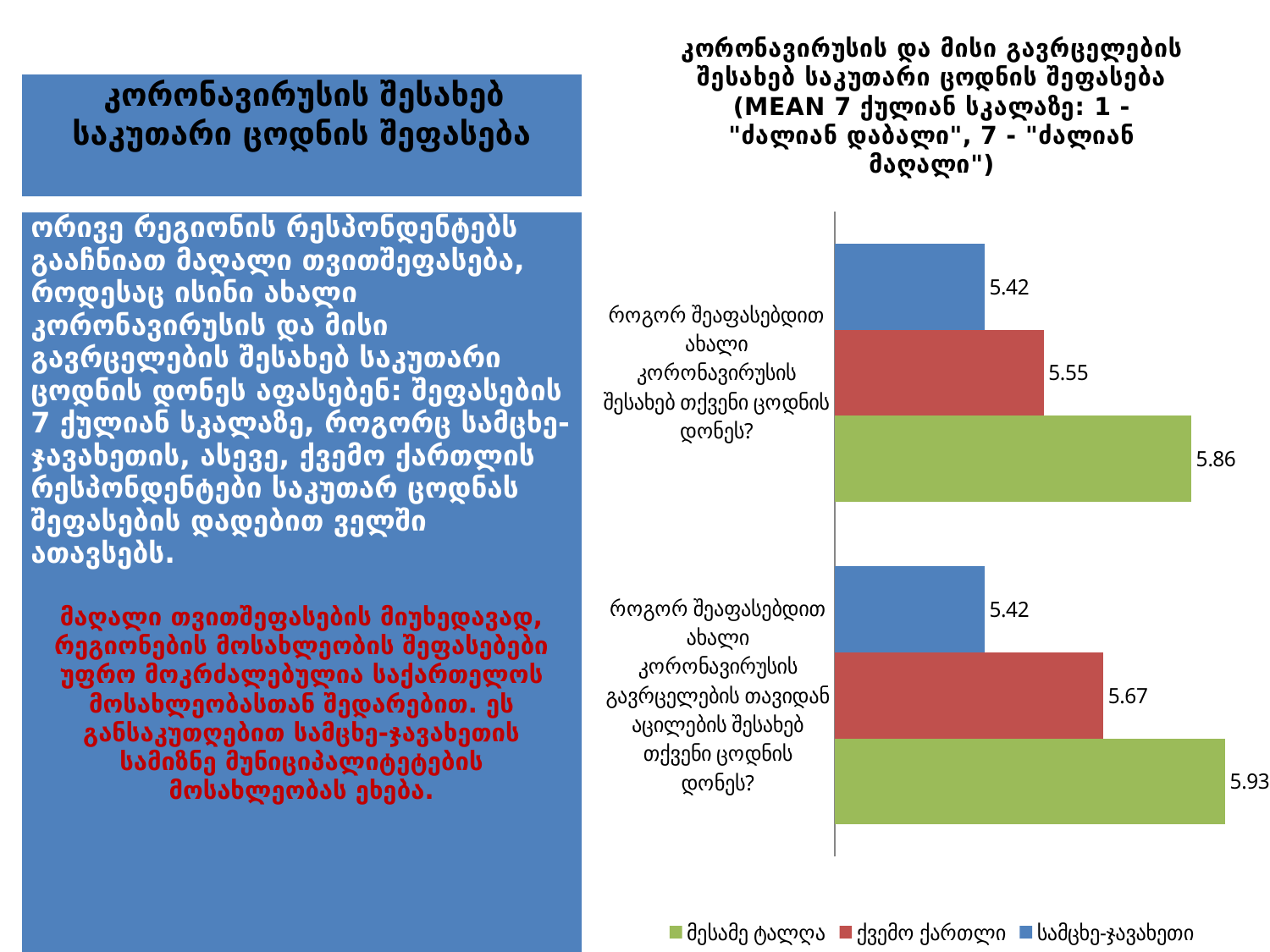
Which series has the highest value for the question about knowledge of preventing the spread of the coronavirus? მესამე ტალღა Which colour represents ქვემო ქართლი in the chart? red How many categories (questions) are plotted on the chart? 2 What is the difference between the ქვემო ქართლი and სამცხე-ჯავახეთი values for the question about knowledge of the new coronavirus? 0.13 What is the value for ქვემო ქართლი for the question about knowledge of preventing the spread of the coronavirus ("...გავრცელების თავიდან აცილების შესახებ თქვენი ცოდნის დონეს?")? 5.67 Which is larger: the ქვემო ქართლი value for the question about knowledge of the new coronavirus, or the ქვემო ქართლი value for the question about preventing its spread? the question about preventing its spread (5.67) What is the value for მესამე ტალღა for the question about knowledge of the new coronavirus ("როგორ შეაფასებდით ახალი კორონავირუსის შესახებ თქვენი ცოდნის დონეს?")? 5.86 How many series does the legend list? 3 Which series has the lowest value for the question about knowledge of the new coronavirus? სამცხე-ჯავახეთი What type of chart is shown on the slide? bar chart What is the difference between the მესამე ტალღა and სამცხე-ჯავახეთი values for the question about knowledge of preventing the spread of the coronavirus? 0.51 What is the value for სამცხე-ჯავახეთი for the question about knowledge of preventing the spread of the coronavirus? 5.42